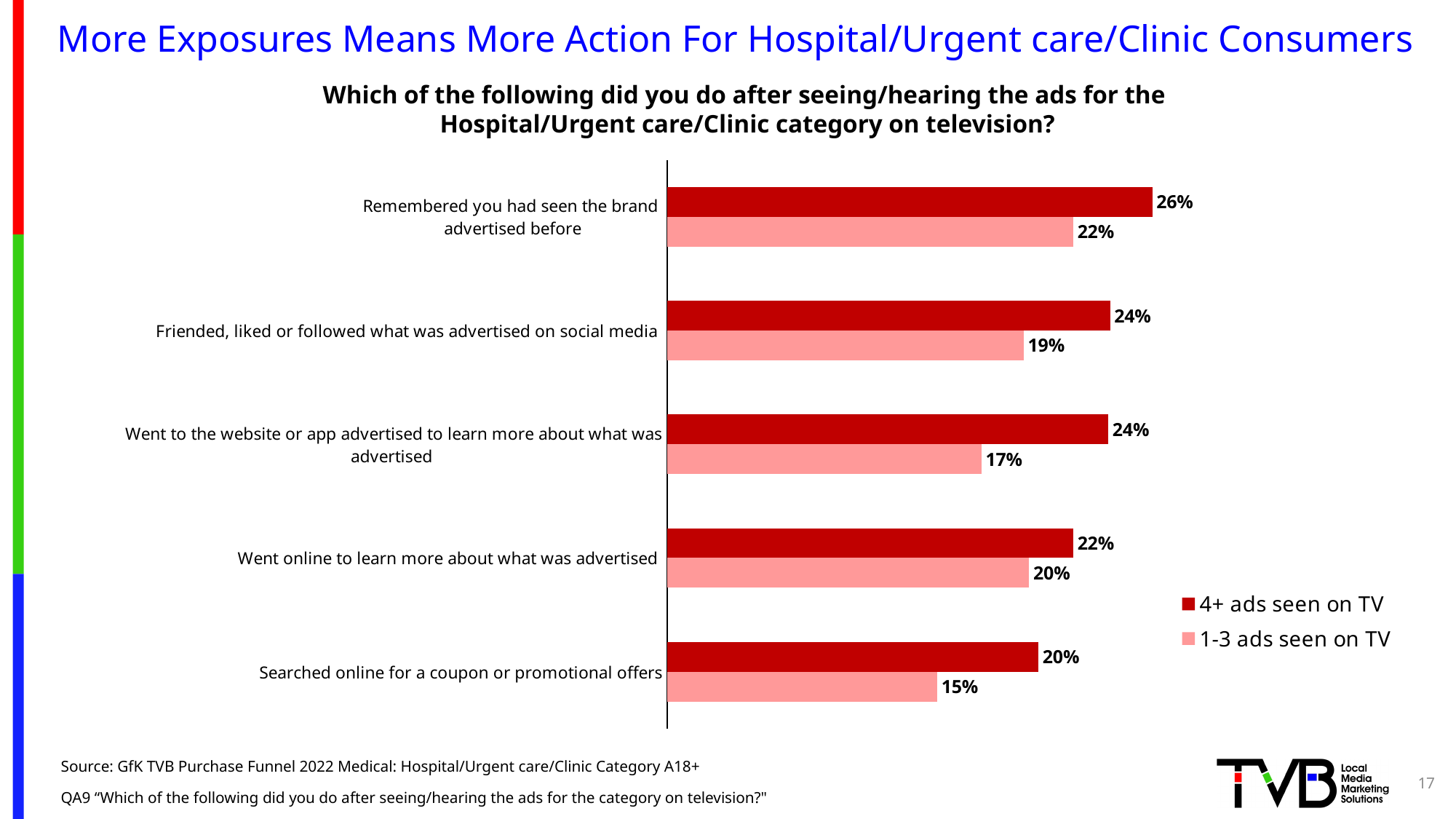
For 'Friended, liked or followed what was advertised on social media', which series has the larger value? 4+ ads seen on TV What is the value for '1-3 ads seen on TV' for 'Searched online for a coupon or promotional offers'? 15% Which action has the lowest value for the '1-3 ads seen on TV' series? Searched online for a coupon or promotional offers Which series is shown in the darker red colour? 4+ ads seen on TV What type of chart is shown on the slide? Bar chart How many actions (categories) are shown in the chart? 5 How many series does the legend list? 2 What is the difference between the '4+ ads seen on TV' and '1-3 ads seen on TV' values for 'Went to the website or app advertised to learn more about what was advertised'? 7 percentage points What percentage of consumers who saw 4+ ads on TV remembered they had seen the brand advertised before? 26% Which action has the highest value for the '4+ ads seen on TV' series? Remembered you had seen the brand advertised before What is the difference between the two series for 'Searched online for a coupon or promotional offers'? 5 percentage points What is the value for '1-3 ads seen on TV' for 'Went to the website or app advertised to learn more about what was advertised'? 17%